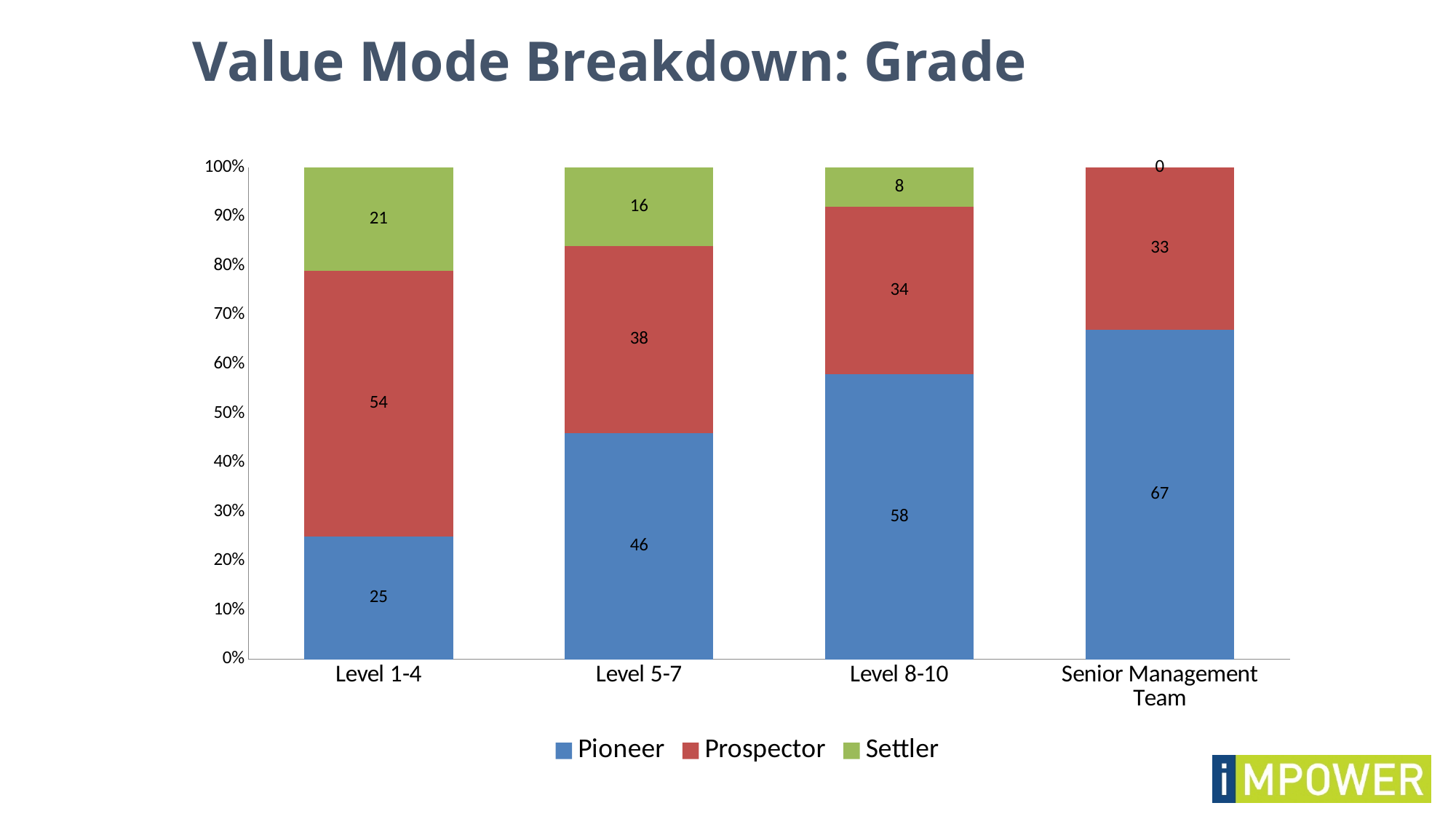
Which category has the highest Pioneer value? Senior Management Team Which is larger, the Prospector value for Level 1-4 or for Level 8-10? Level 1-4 What is the difference between the Pioneer values for Level 8-10 and Level 1-4? 33 What is the Pioneer value for Level 1-4? 25 How many series does the legend list? 3 What is the Prospector value for Level 5-7? 38 What is the Settler value for the Senior Management Team? 0 What is the Settler value for Level 8-10? 8 Which category has the lowest Settler value? Senior Management Team What kind of chart is shown on the slide? Stacked bar chart How many categories are shown on the x axis? 4 Do the Pioneer values rise or fall from Level 1-4 to Senior Management Team? Rise